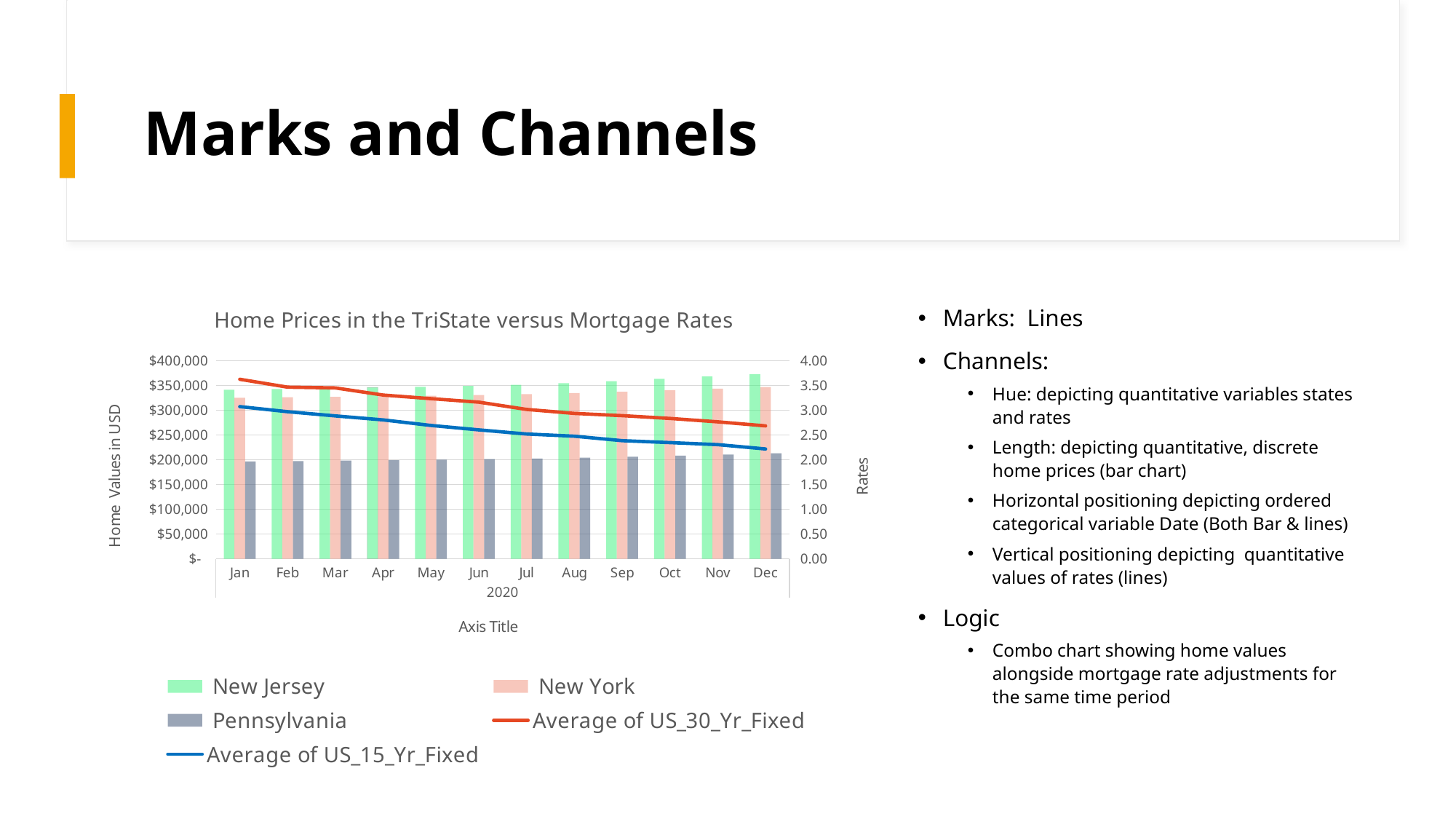
What is the title of the chart? Home Prices in the TriState versus Mortgage Rates Do the Average of US_30_Yr_Fixed values rise or fall from Jan to Dec? Fall Is the Average of US_15_Yr_Fixed value for Dec greater or less than 2.50? less How many months are shown along the x axis of the chart? 12 In Dec, which is larger: the New Jersey bar or the Pennsylvania bar? New Jersey What kind of chart is shown on the slide? Combo chart with bars and lines Do the New Jersey bars rise or fall from Jan to Dec? Rise Is the Pennsylvania value for Jan greater or less than $250,000? less What is the label of the left vertical axis? Home Values in USD In which month is the New Jersey bar highest? Dec How many series does the chart legend list? 5 Is the New Jersey value for Dec greater or less than $350,000? greater